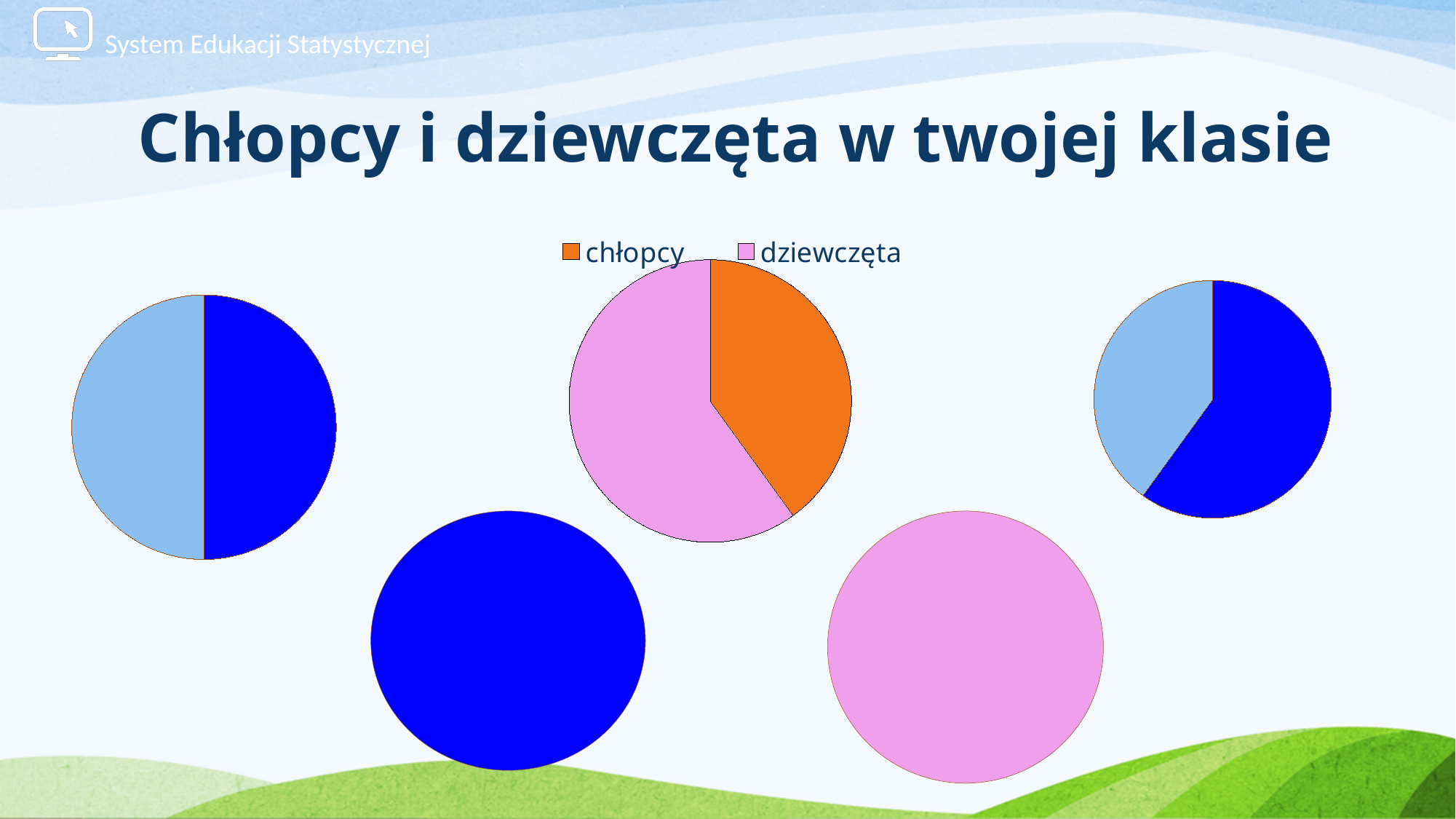
In the central pie chart, which category has the largest slice? dziewczęta What colour is the dziewczęta slice in the central pie chart? pink How many categories does the legend of the central pie chart list? 2 In the central pie chart, which category has the smallest slice? chłopcy What colour is the chłopcy slice in the central pie chart? orange What kind of chart is the central chart with the legend on the slide? pie chart What is the title of the slide containing the pie chart? Chłopcy i dziewczęta w twojej klasie In the central pie chart, which slice is larger, chłopcy or dziewczęta? dziewczęta